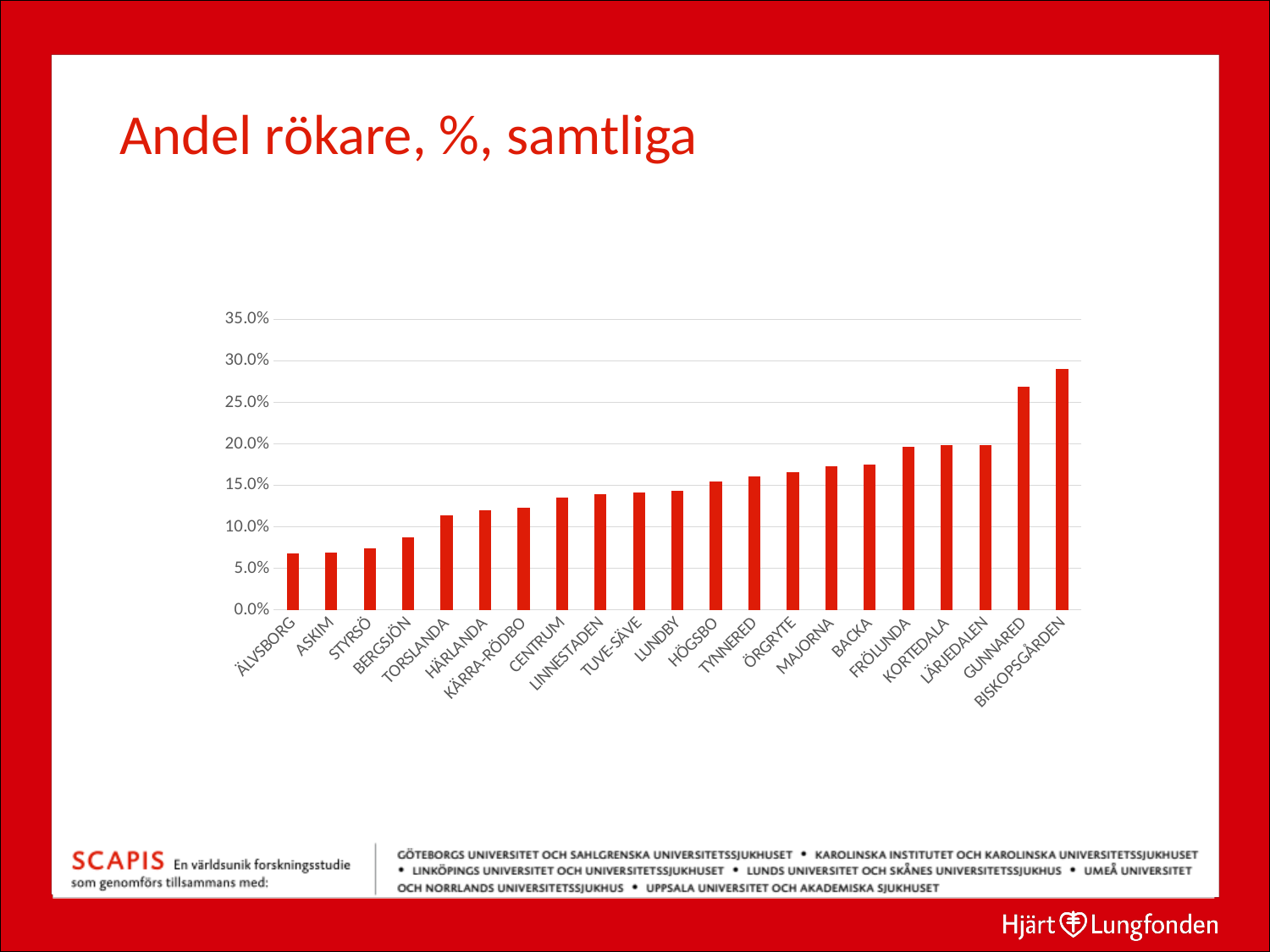
What kind of chart is shown on the slide? bar chart Is the value for BISKOPSGÅRDEN greater or less than 25.0%? greater Is the value for ÄLVSBORG greater or less than 10.0%? less Do the values rise or fall from left to right along the x axis? rise Which has the larger value, GUNNARED or BISKOPSGÅRDEN? BISKOPSGÅRDEN Which has the larger value, STYRSÖ or TORSLANDA? TORSLANDA What is the title of the chart? Andel rökare, %, samtliga Is the value for GUNNARED greater or less than 25.0%? greater Which district has the highest share of smokers in the chart? BISKOPSGÅRDEN How many districts (categories) are shown on the x axis of the chart? 21